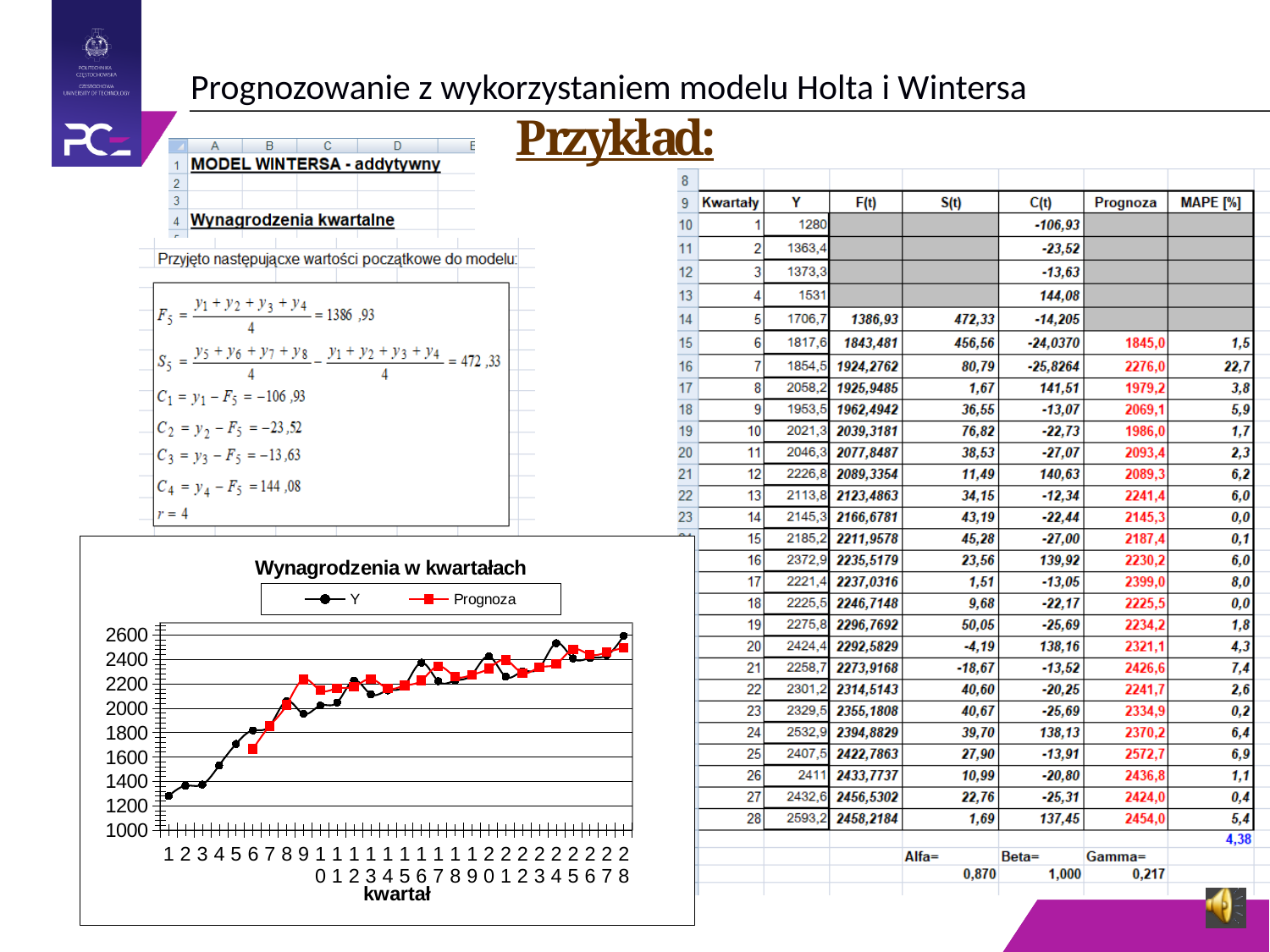
Which series in the chart is drawn in red? Prognoza How many series does the chart's legend list? 2 Do the Y values in the chart generally rise or fall across the quarters? rise Is the Prognoza value for quarter 6 greater or less than 2000? less Which quarter has the lowest Y value in the chart? 1 Which is larger in the chart: the Y value for quarter 1 or the Y value for quarter 28? quarter 28 What kind of chart is shown on the slide? line chart How many quarters are plotted along the x axis of the chart? 28 What is the title of the chart on the slide? Wynagrodzenia w kwartałach Is the Y value for quarter 28 greater or less than 2400? greater Is the Y value for quarter 1 greater or less than 1400? less What is the label of the x axis of the chart? kwartał